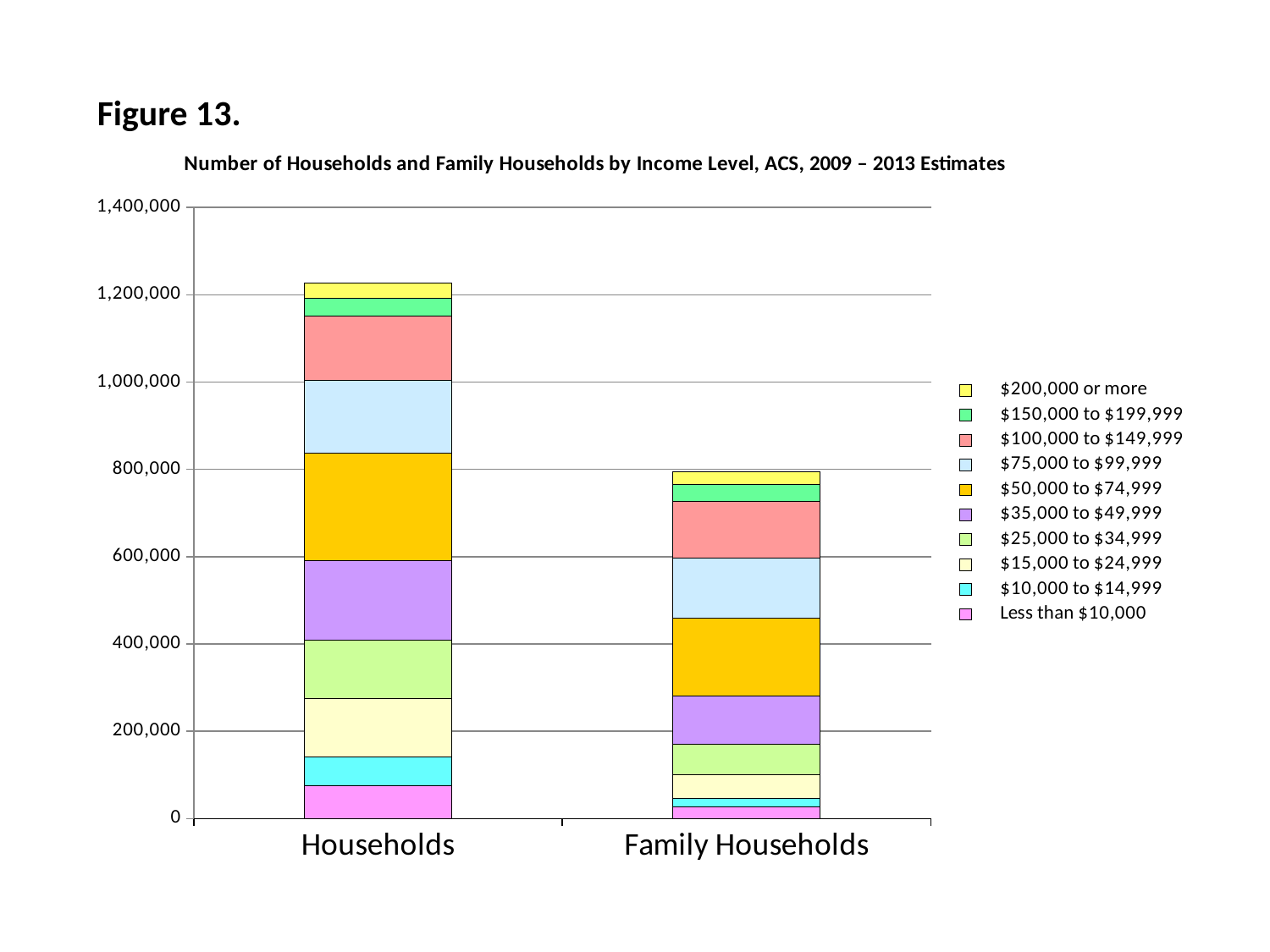
Is the total for Households greater or less than 1,000,000? greater How many series does the legend list? 10 Is the value of the 'Less than $10,000' segment for Households greater or less than 200,000? less Which legend entry is listed first (at the top of the legend)? $200,000 or more Which category has the taller stacked bar, Households or Family Households? Households Is the total for Family Households greater or less than 1,000,000? less What kind of chart is shown on the slide? Stacked bar chart How many categories are shown on the x axis? 2 Which category has the lowest total? Family Households What is the title of the chart? Number of Households and Family Households by Income Level, ACS, 2009 – 2013 Estimates